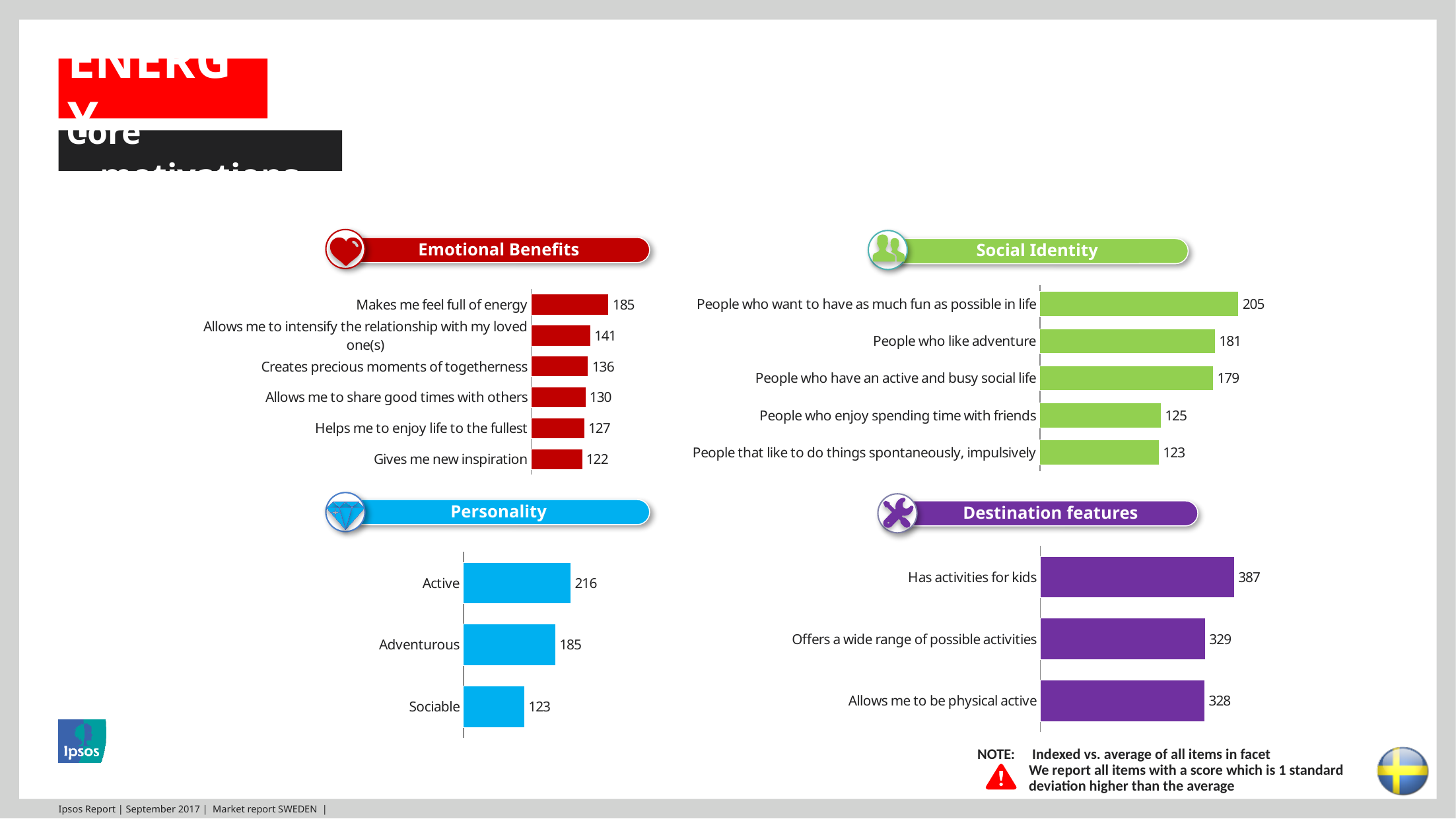
In the Destination features chart, what is the value for "Allows me to be physical active"? 328 In the Personality chart, what is the value for "Adventurous"? 185 In the Destination features chart, which category has the highest value? Has activities for kids In the Emotional Benefits chart, which is larger: "Creates precious moments of togetherness" or "Helps me to enjoy life to the fullest"? Creates precious moments of togetherness In the Emotional Benefits chart, what is the value for "Makes me feel full of energy"? 185 In the Personality chart, how many categories are shown? 3 In the Social Identity chart, which category has the highest value? People who want to have as much fun as possible in life In the Destination features chart, what is the difference between "Has activities for kids" and "Offers a wide range of possible activities"? 58 In the Social Identity chart, what is the difference between "People who want to have as much fun as possible in life" and "People that like to do things spontaneously, impulsively"? 82 In the Social Identity chart, what is the value for "People who like adventure"? 181 In the Emotional Benefits chart, which category has the lowest value? Gives me new inspiration What type of chart is the Personality chart? Bar chart